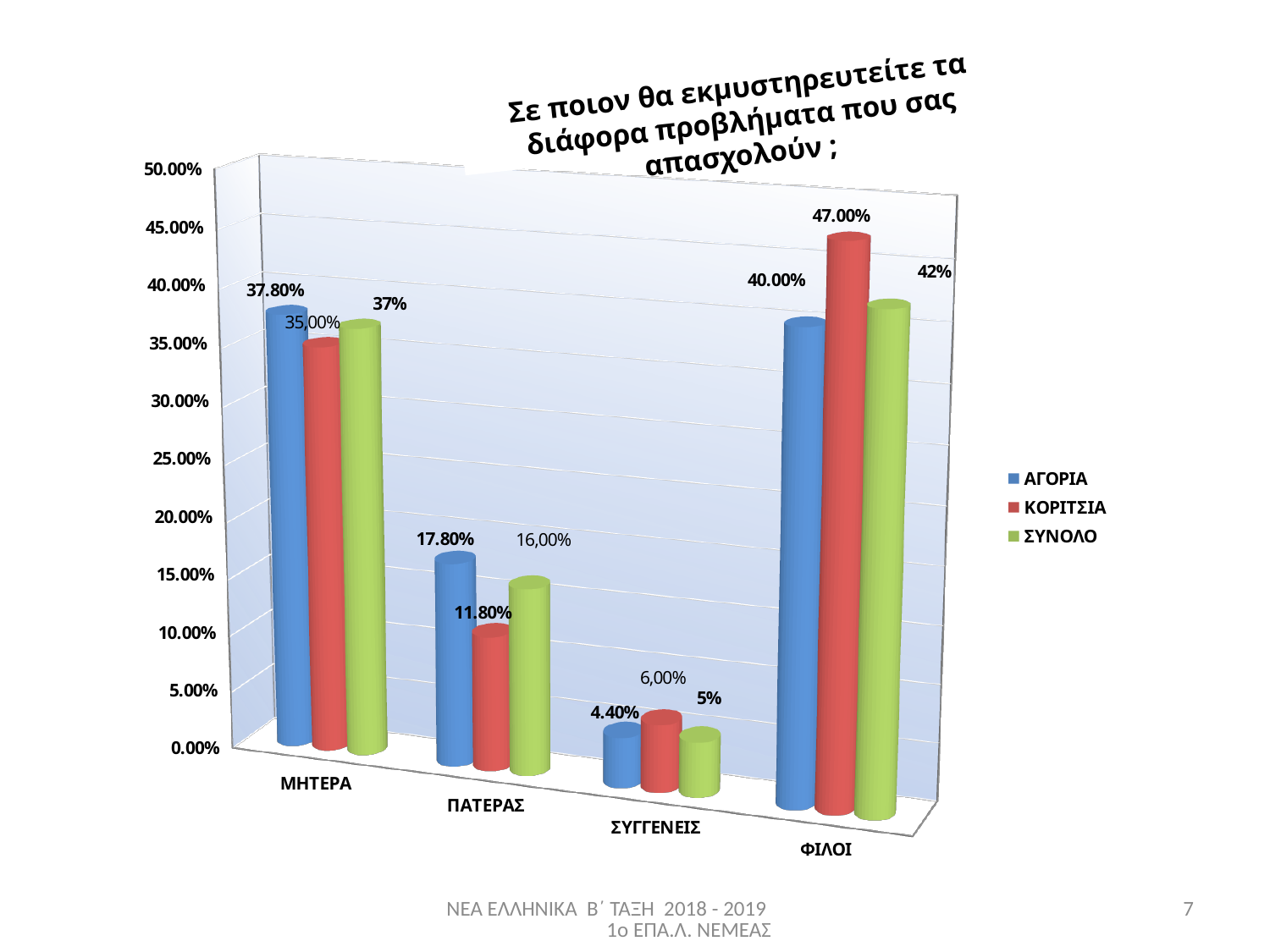
What is the value for ΚΟΡΙΤΣΙΑ in the ΦΙΛΟΙ category? 47.00% In the ΦΙΛΟΙ category, which is larger: the ΑΓΟΡΙΑ value or the ΚΟΡΙΤΣΙΑ value? ΚΟΡΙΤΣΙΑ Is the ΣΥΝΟΛΟ value for ΦΙΛΟΙ greater or less than 40.00%? greater What is the value for ΑΓΟΡΙΑ in the ΜΗΤΕΡΑ category? 37.80% Which category has the lowest value for ΑΓΟΡΙΑ? ΣΥΓΓΕΝΕΙΣ How many categories are shown on the x axis? 4 What is the difference between the ΑΓΟΡΙΑ and ΚΟΡΙΤΣΙΑ values in the ΠΑΤΕΡΑΣ category? 6.00% What is the value for ΣΥΝΟΛΟ in the ΠΑΤΕΡΑΣ category? 16,00% What is the value for ΚΟΡΙΤΣΙΑ in the ΣΥΓΓΕΝΕΙΣ category? 6,00% What kind of chart is shown on the slide? bar chart Which category has the highest value for ΚΟΡΙΤΣΙΑ? ΦΙΛΟΙ How many series does the legend list? 3